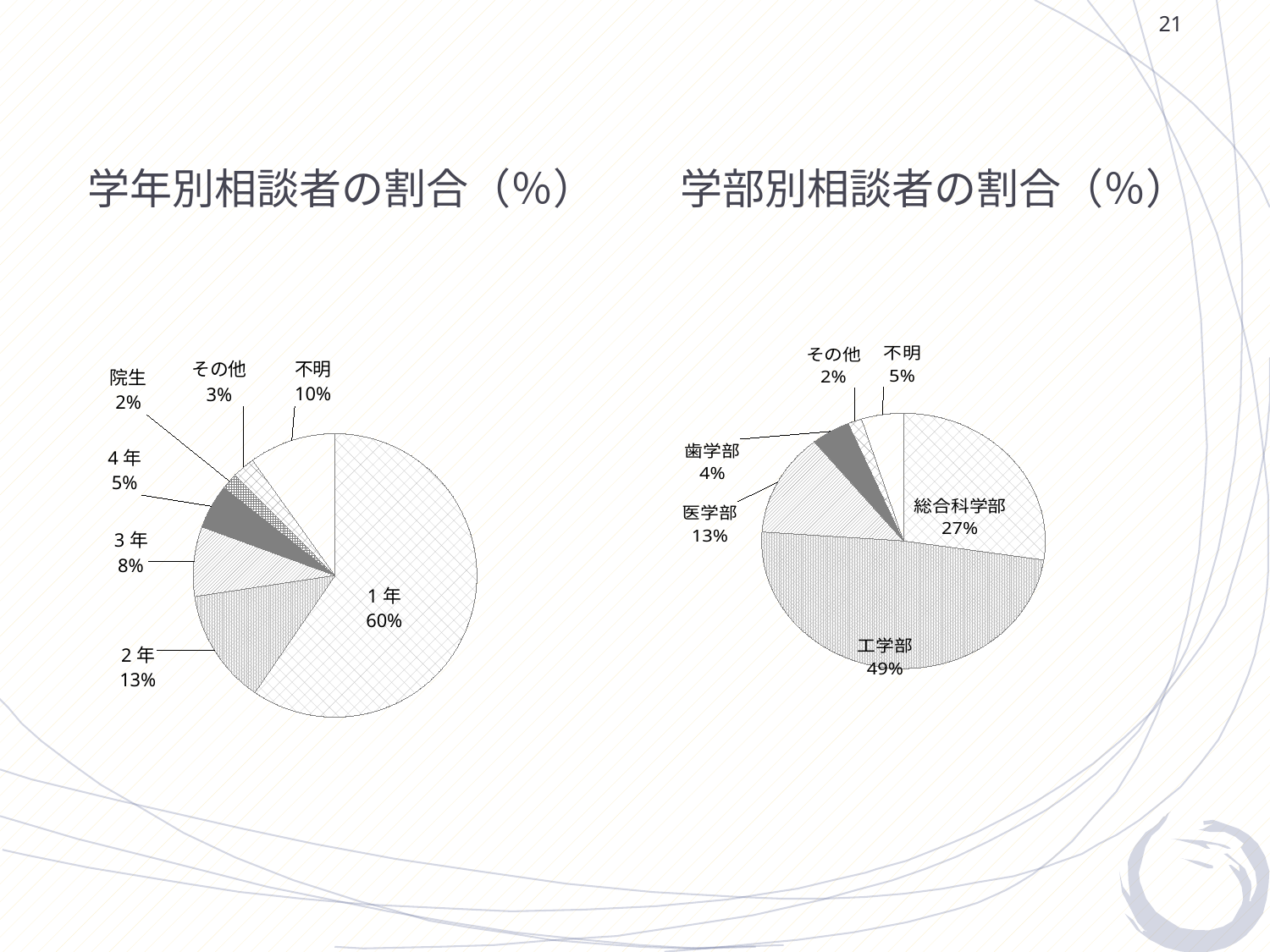
In the 学部別相談者の割合（%） chart on the right, which is larger, 歯学部 or 不明? 不明 In the 学部別相談者の割合（%） chart on the right, how many categories are shown? 6 In the 学年別相談者の割合（%） chart on the left, how many categories are shown? 7 In the 学年別相談者の割合（%） chart on the left, which category has the largest share? 1年 In the 学年別相談者の割合（%） chart on the left, what share is 不明? 10% In the 学年別相談者の割合（%） chart on the left, what is the difference between the shares of 2年 and 3年? 5% In the 学部別相談者の割合（%） chart on the right, what share is 医学部? 13% In the 学年別相談者の割合（%） chart on the left, what share is 1年? 60% What kind of chart is used for the 学部別相談者の割合（%） chart on the right? Pie chart In the 学年別相談者の割合（%） chart on the left, which category has the smallest share? 院生 In the 学部別相談者の割合（%） chart on the right, which category has the largest share? 工学部 In the 学部別相談者の割合（%） chart on the right, what share is 工学部? 49%